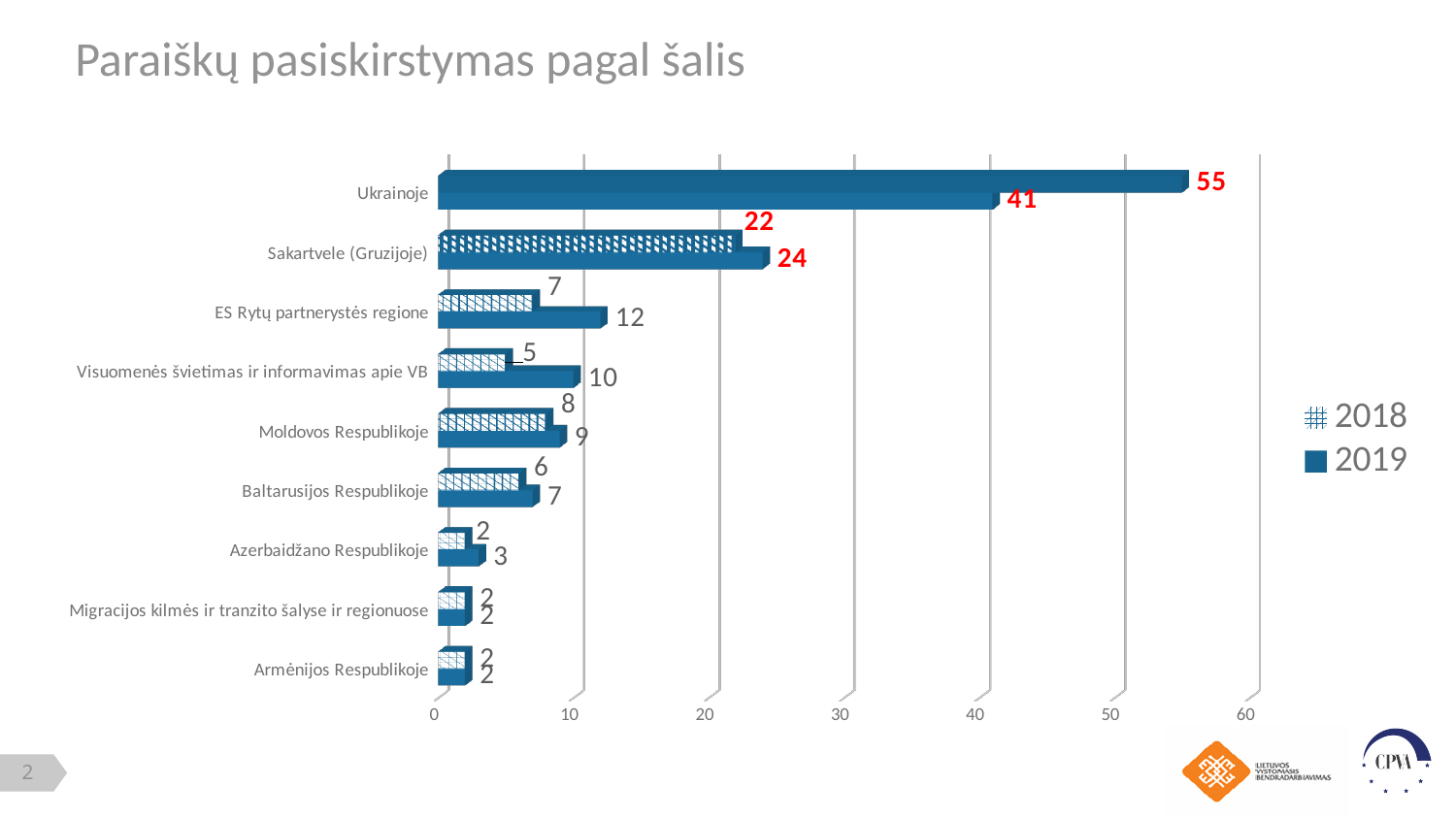
What type of chart is shown on the slide? bar chart How many categories are shown on the chart? 9 What is the 2019 value for Visuomenės švietimas ir informavimas apie VB? 10 What is the 2019 value for Azerbaidžano Respublikoje? 3 Which category has the highest value on the chart? Ukrainoje What is the title of the chart? Paraiškų pasiskirstymas pagal šalis What is the difference between the 2019 and 2018 values for ES Rytų partnerystės regione? 5 What is the 2018 value for ES Rytų partnerystės regione? 7 Which is larger, the 2019 value for Moldovos Respublikoje or the 2019 value for Baltarusijos Respublikoje? Moldovos Respublikoje What is the largest value shown for Ukrainoje? 55 What is the 2019 value for Sakartvele (Gruzijoje)? 24 How many series does the legend list? 2